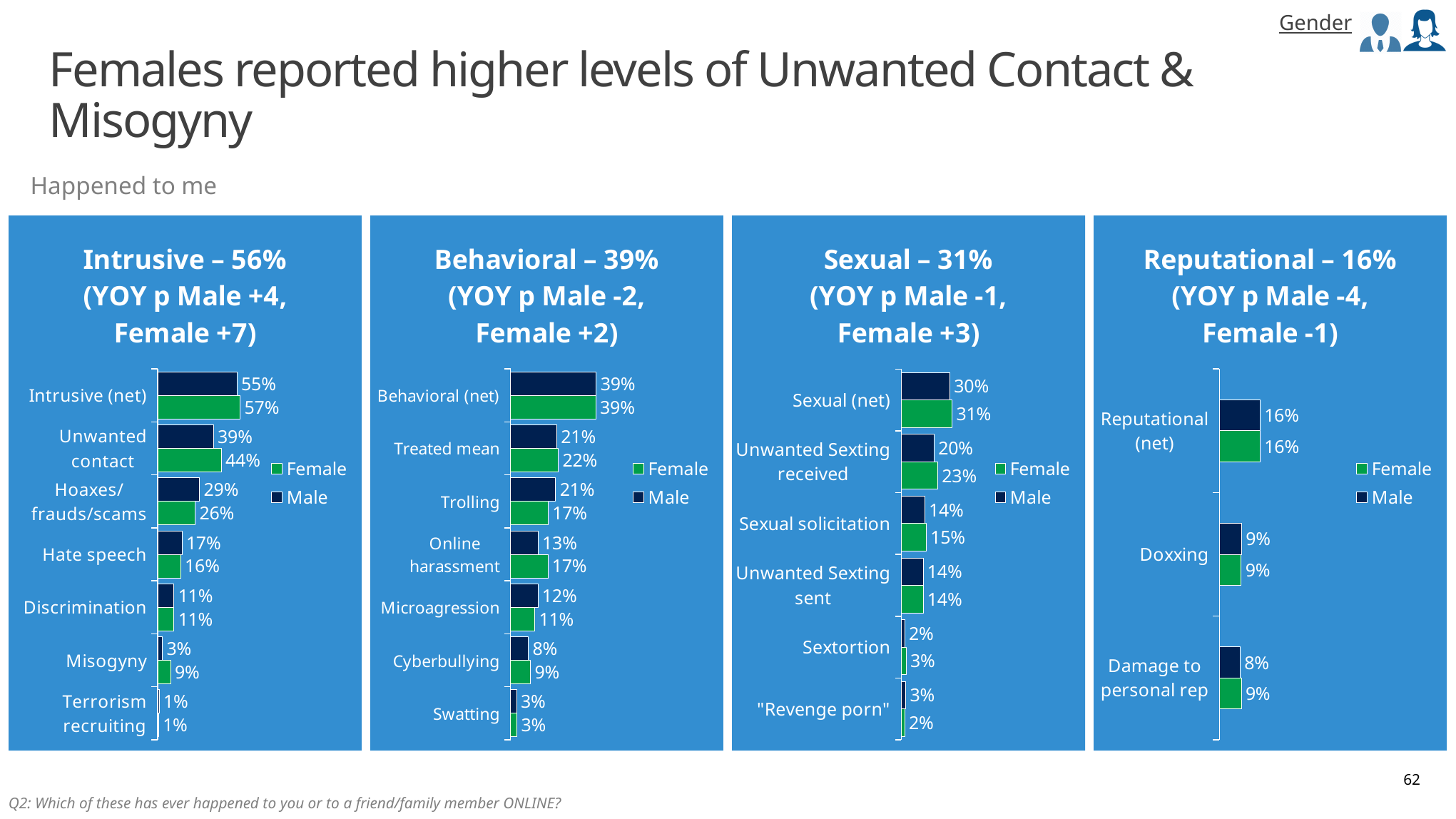
In the Reputational chart, how many series does the legend list? 2 In the Sexual chart, what is the Female value for Unwanted Sexting received? 23% In the Sexual chart, what is the difference between the Female and Male values for Unwanted Sexting received? 3% In the Behavioral chart, what is the Female value for Online harassment? 17% What type of chart is the Reputational chart? Bar chart In the Intrusive chart, what is the Male value for Misogyny? 3% In the Behavioral chart, how many categories are plotted? 7 In the Intrusive chart, what is the difference between the Female and Male values for Misogyny? 6% In the Intrusive chart, what is the Female value for Unwanted contact? 44% In the Reputational chart, what is the Female value for Damage to personal rep? 9% In the Behavioral chart, which is larger for Trolling, the Male value or the Female value? Male In the Sexual chart, which category has the lowest Male value? Sextortion